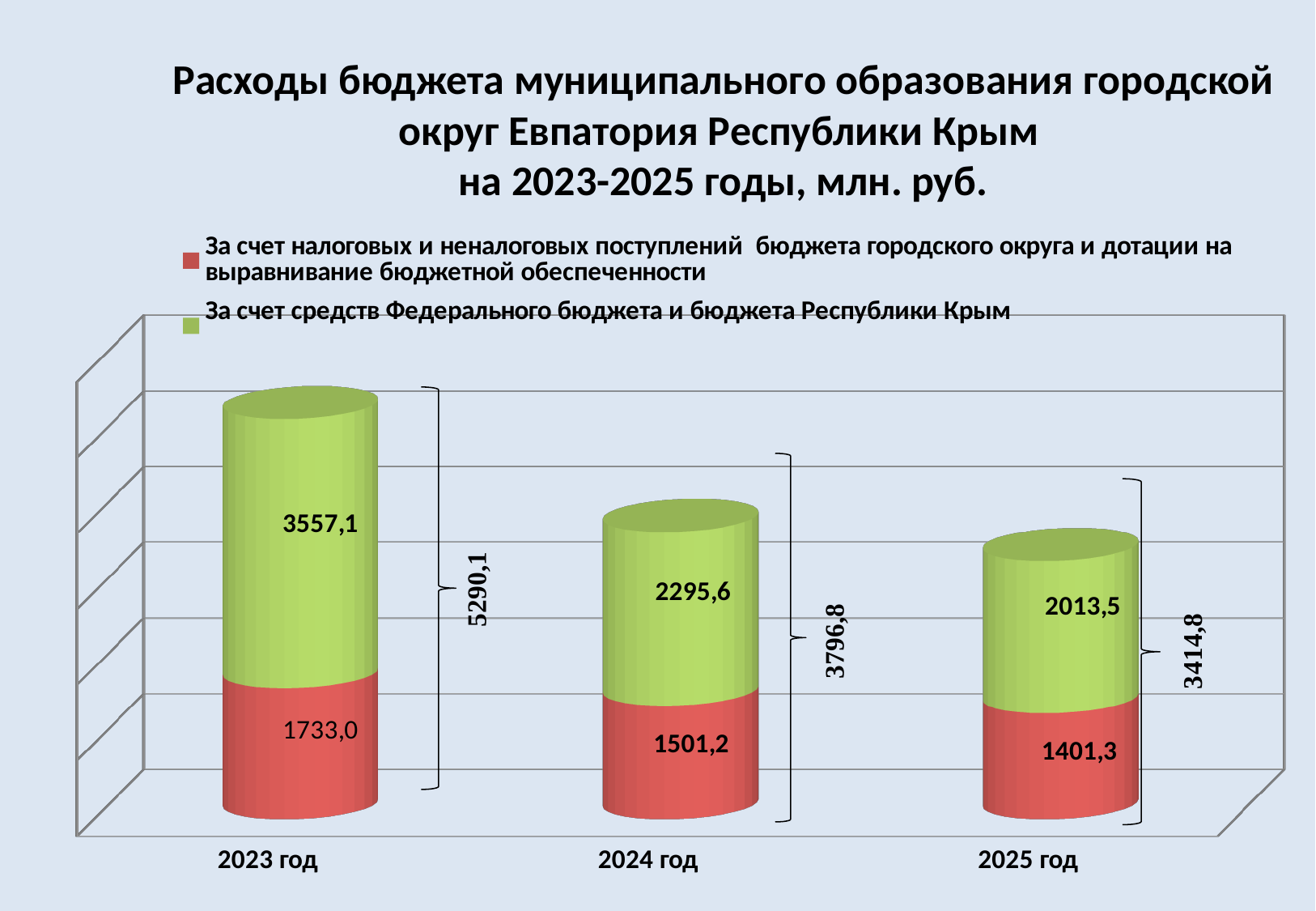
What is the value of the red series (За счет налоговых и неналоговых поступлений бюджета городского округа и дотации на выравнивание бюджетной обеспеченности) for 2024 год? 1501,2 What is the total of the stacked bar for 2025 год? 3414,8 What is the difference between the green series values for 2023 год and 2024 год? 1261,5 Which is larger: the red series value for 2023 год or the red series value for 2025 год? 2023 год Do the total values rise or fall from 2023 год to 2025 год? fall Which year has the highest total budget expenditure? 2023 год Which year has the lowest value for the red series? 2025 год What is the total of the stacked bar for 2024 год? 3796,8 How many series does the legend list? 2 What is the difference between the total for 2023 год and the total for 2025 год? 1875,3 What is the value of the green series (За счет средств Федерального бюджета и бюджета Республики Крым) for 2023 год? 3557,1 What is the value of the green series for 2025 год? 2013,5